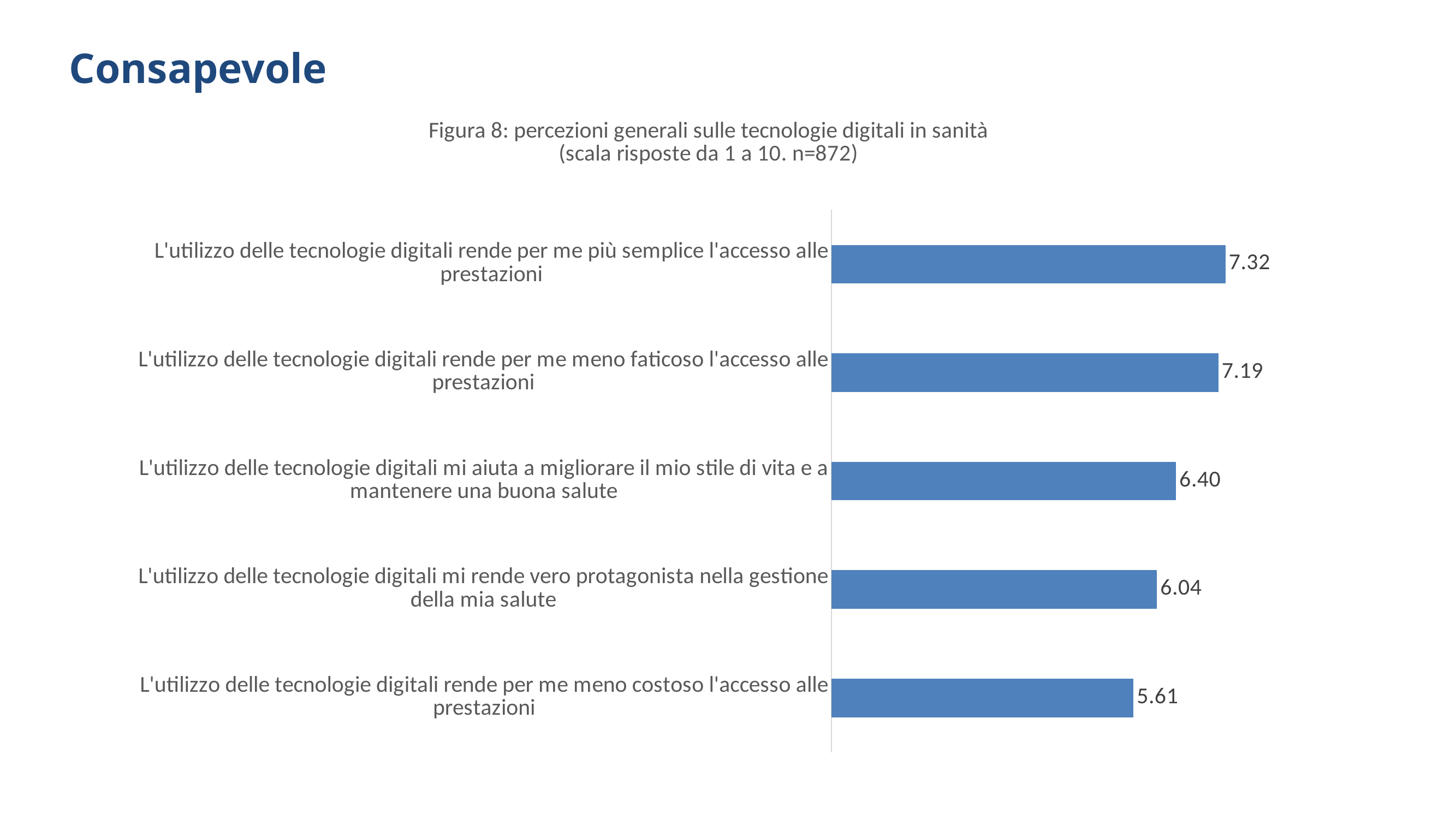
What is the value for "L'utilizzo delle tecnologie digitali mi aiuta a migliorare il mio stile di vita e a mantenere una buona salute"? 6.40 Which is larger: the value for "mi aiuta a migliorare il mio stile di vita" or the value for "mi rende vero protagonista nella gestione della mia salute"? mi aiuta a migliorare il mio stile di vita What is the value for "L'utilizzo delle tecnologie digitali rende per me più semplice l'accesso alle prestazioni"? 7.32 Which statement has the highest value? L'utilizzo delle tecnologie digitali rende per me più semplice l'accesso alle prestazioni What is the value for "L'utilizzo delle tecnologie digitali rende per me meno costoso l'accesso alle prestazioni"? 5.61 What is the sample size (n) stated in the chart title? 872 What is the value for "L'utilizzo delle tecnologie digitali mi rende vero protagonista nella gestione della mia salute"? 6.04 What is the difference between the value for "più semplice l'accesso alle prestazioni" and the value for "meno costoso l'accesso alle prestazioni"? 1.71 Which statement has the lowest value? L'utilizzo delle tecnologie digitali rende per me meno costoso l'accesso alle prestazioni What is the value for "L'utilizzo delle tecnologie digitali rende per me meno faticoso l'accesso alle prestazioni"? 7.19 How many statements (bars) are shown in the chart? 5 What kind of chart is shown on the slide? Bar chart